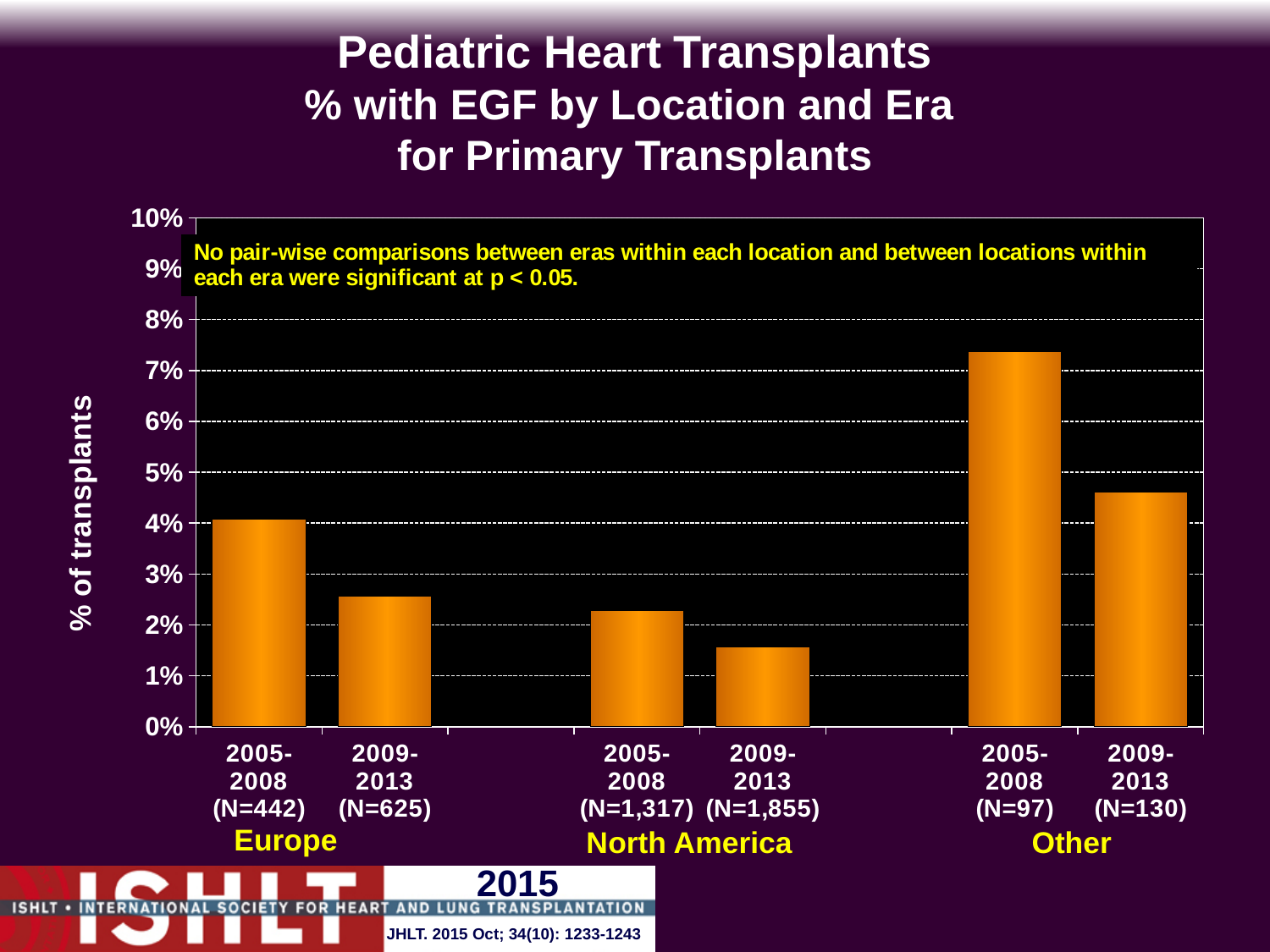
Which bar has the highest % of transplants with EGF? Other, 2005-2008 Is the value for North America 2009-2013 greater or less than 2%? less What is the N shown for North America 2009-2013? N=1,855 Is the value for Other 2005-2008 greater or less than 7%? greater Is the value for Other 2009-2013 greater or less than 5%? less What is the label on the vertical axis? % of transplants Which is larger: the value for Europe 2009-2013 or North America 2009-2013? Europe 2009-2013 Which bar has the lowest % of transplants with EGF? North America, 2009-2013 What kind of chart is shown on the slide? bar chart How many bars are plotted in the chart? 6 Within each location, does the % with EGF rise or fall from the 2005-2008 era to the 2009-2013 era? fall